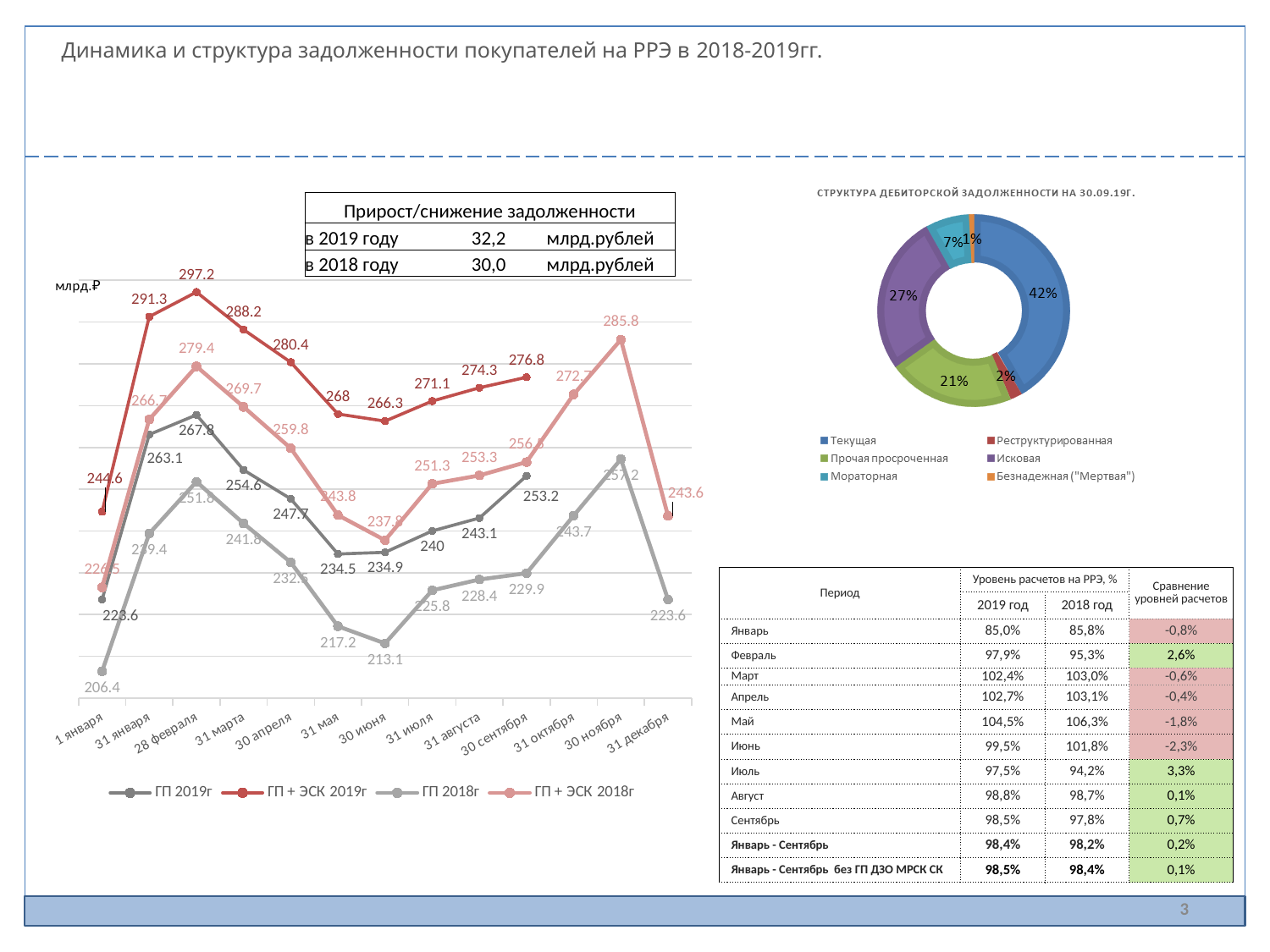
In the doughnut chart 'СТРУКТУРА ДЕБИТОРСКОЙ ЗАДОЛЖЕННОСТИ НА 30.09.19Г.', what share does Исковая have? 27% On the line chart, what is the value of the ГП 2018г series on 1 января? 206.4 On the line chart, what is the value of the ГП + ЭСК 2018г series on 30 ноября? 285.8 What type of chart is the chart titled 'СТРУКТУРА ДЕБИТОРСКОЙ ЗАДОЛЖЕННОСТИ НА 30.09.19Г.'? Doughnut chart How many series does the legend of the line chart list? 4 On the line chart, at which date does the ГП 2018г series have its lowest value? 1 января On the line chart, what is the difference between the ГП + ЭСК 2019г and ГП + ЭСК 2018г values on 31 января? 24.6 On the line chart, what is the value of the ГП + ЭСК 2019г series on 28 февраля? 297.2 In the doughnut chart 'СТРУКТУРА ДЕБИТОРСКОЙ ЗАДОЛЖЕННОСТИ НА 30.09.19Г.', which category has the largest share? Текущая On the line chart, which is larger on 30 июня: ГП 2019г or ГП 2018г? ГП 2019г On the line chart, at which date does the ГП + ЭСК 2019г series reach its highest value? 28 февраля On the line chart, what is the value of the ГП 2019г series on 30 сентября? 253.2